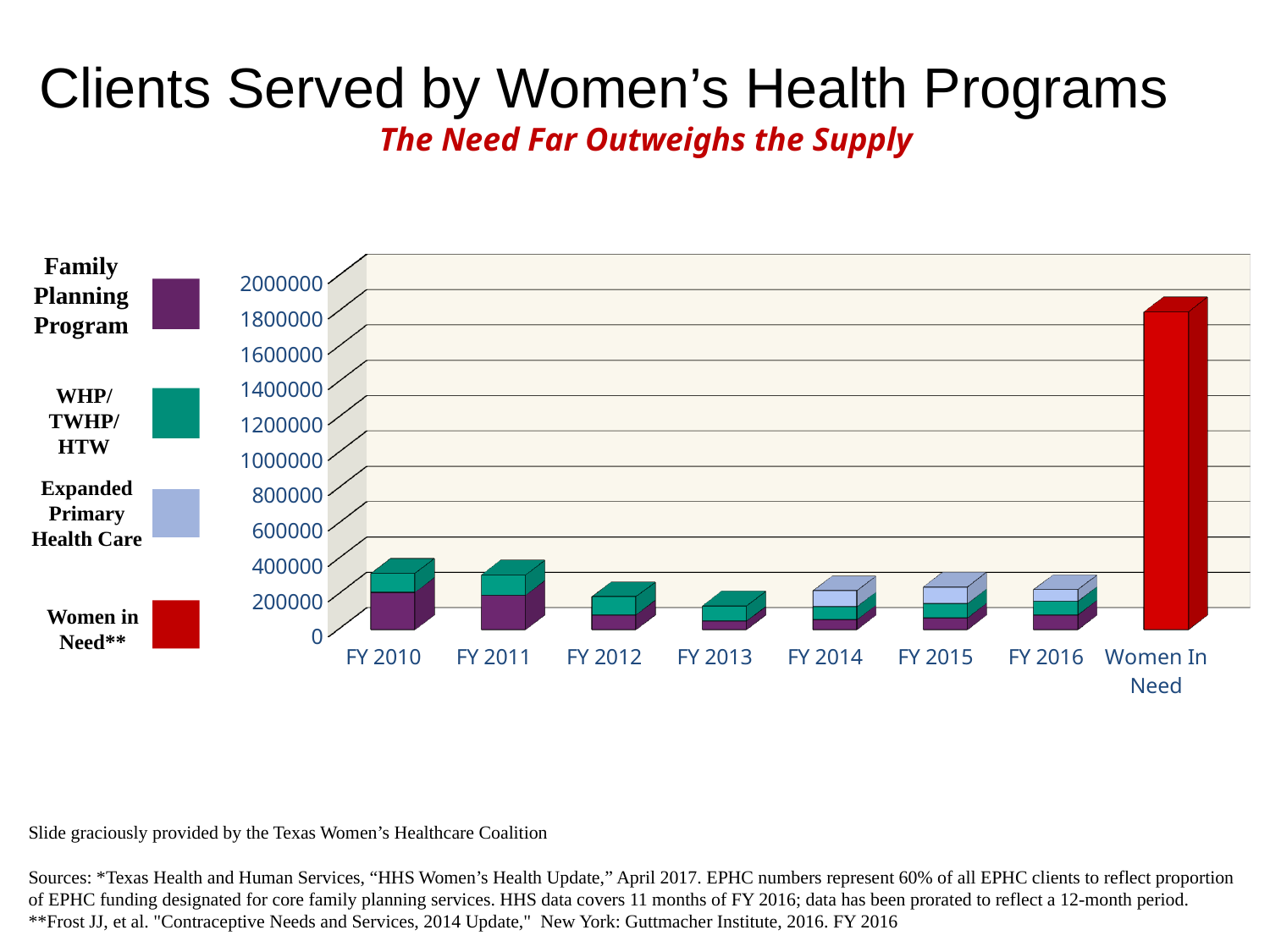
Which is larger, the bar for Women In Need or the bar for FY 2010? Women In Need Do the stacked bar totals rise or fall from FY 2010 to FY 2013? fall Is the total value for FY 2010 greater or less than 600000? less Which is larger, the stacked bar for FY 2010 or the stacked bar for FY 2013? FY 2010 Which fiscal year has the shortest stacked bar in the chart? FY 2013 How many categories are shown along the x axis of the chart? 8 How many series does the legend list? 4 Which category has the tallest bar in the chart? Women In Need What kind of chart is shown on the slide? Stacked bar chart Is the total value for FY 2013 greater or less than 400000? less Is the value for Women In Need greater or less than 1000000? greater What colour is used for the Women in Need series in the chart? Red